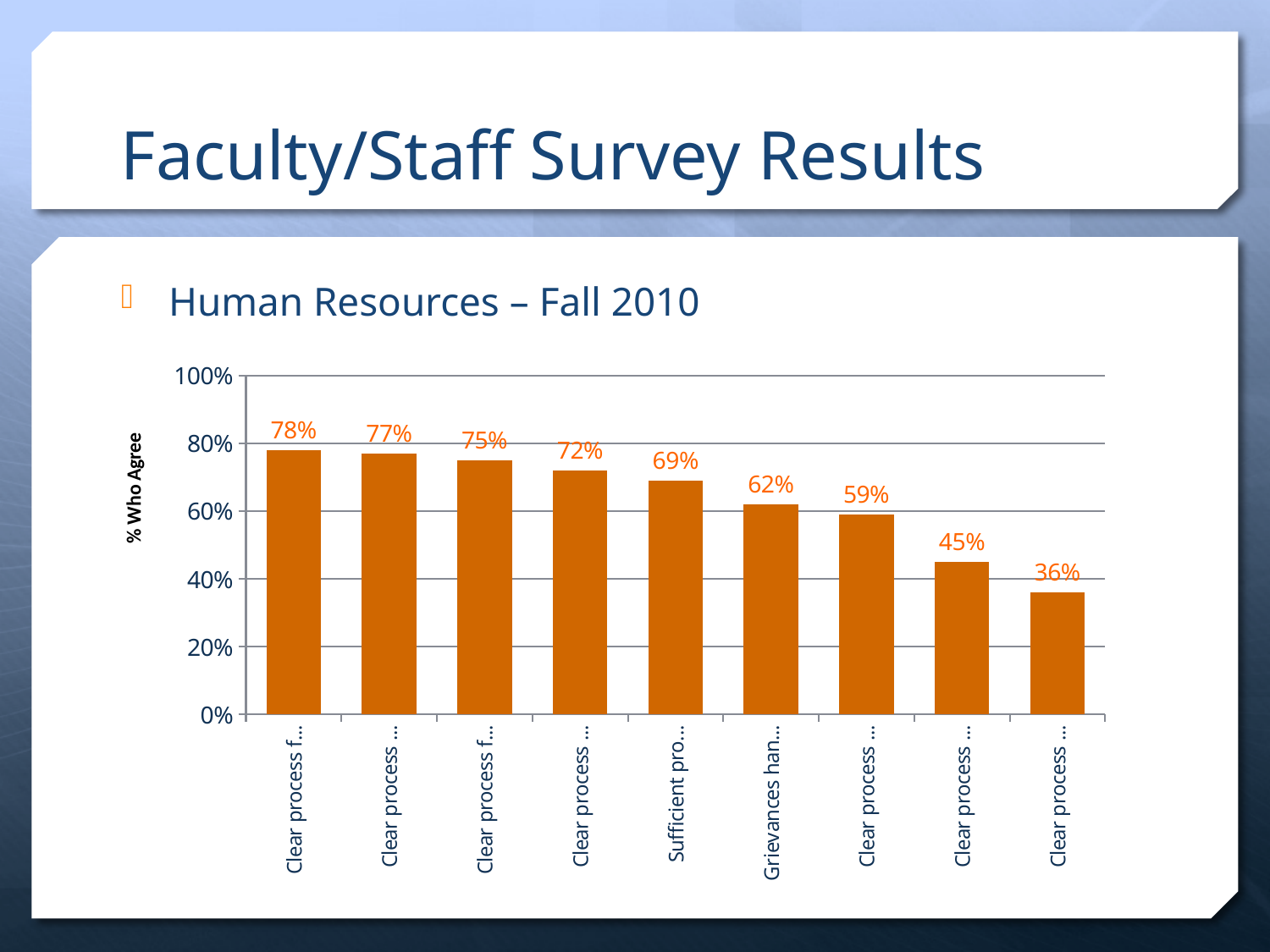
What kind of chart is shown on the slide? Bar chart Do the values rise or fall moving from left to right across the chart? Fall What is the lowest value shown in the chart? 36% How many bars are plotted in the chart? 9 What is the title of the vertical axis? % Who Agree Which is larger, the value of the sixth bar from the left or the seventh bar from the left? The sixth bar (62%) What is the difference between the highest and lowest values in the chart? 42% What is the value of the leftmost bar in the chart? 78% What is the value of the bar labelled 'Grievances han...'? 62% What is the highest value shown in the chart? 78% What is the value of the rightmost bar in the chart? 36% What is the value of the fifth bar from the left? 69%